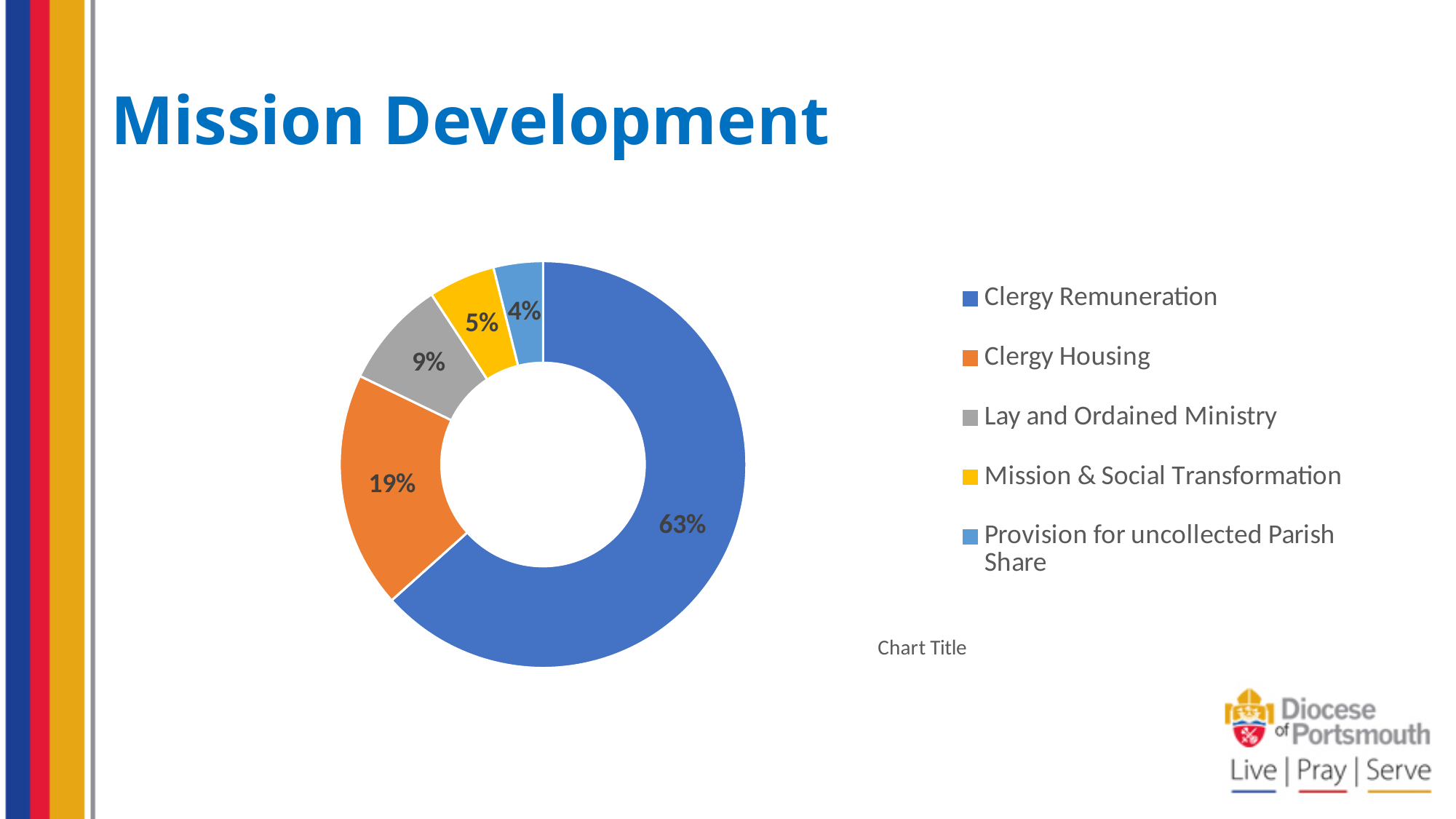
Which is larger, the share for Lay and Ordained Ministry or the share for Mission & Social Transformation? Lay and Ordained Ministry Which category has the smallest share of the chart? Provision for uncollected Parish Share What kind of chart is shown on the slide? Doughnut (pie) chart What share of the chart does Clergy Housing represent? 19% Which category has the largest share of the chart? Clergy Remuneration How many categories are shown in the chart? 5 What colour is the Clergy Housing segment in the chart? Orange What share of the chart does Lay and Ordained Ministry represent? 9% What share of the chart does Mission & Social Transformation represent? 5% What is the difference in percentage points between Clergy Remuneration and Clergy Housing? 44